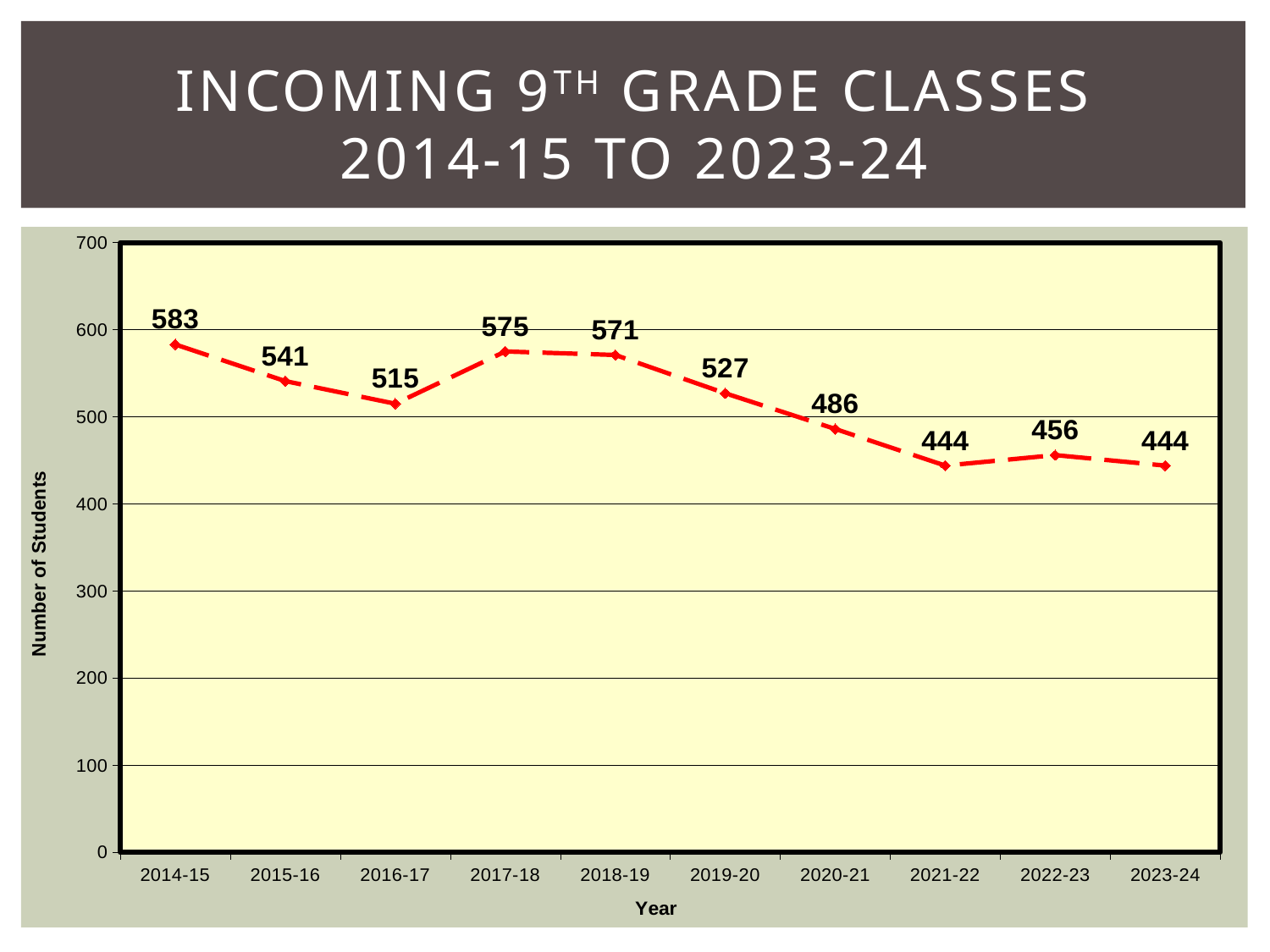
What is the number of students for 2022-23? 456 How many years are plotted on the chart? 10 Which year has more students, 2018-19 or 2020-21? 2018-19 What is the number of students for 2014-15? 583 Which year has the lowest number of students? 2021-22 and 2023-24 Overall, do the values rise or fall from 2014-15 to 2023-24? fall What is the difference in number of students between 2017-18 and 2016-17? 60 What kind of chart is shown on the slide? line chart What is the difference in number of students between 2014-15 and 2023-24? 139 What is the number of students for 2019-20? 527 Which year has the highest number of students? 2014-15 Is the value for 2020-21 greater or less than 500? less